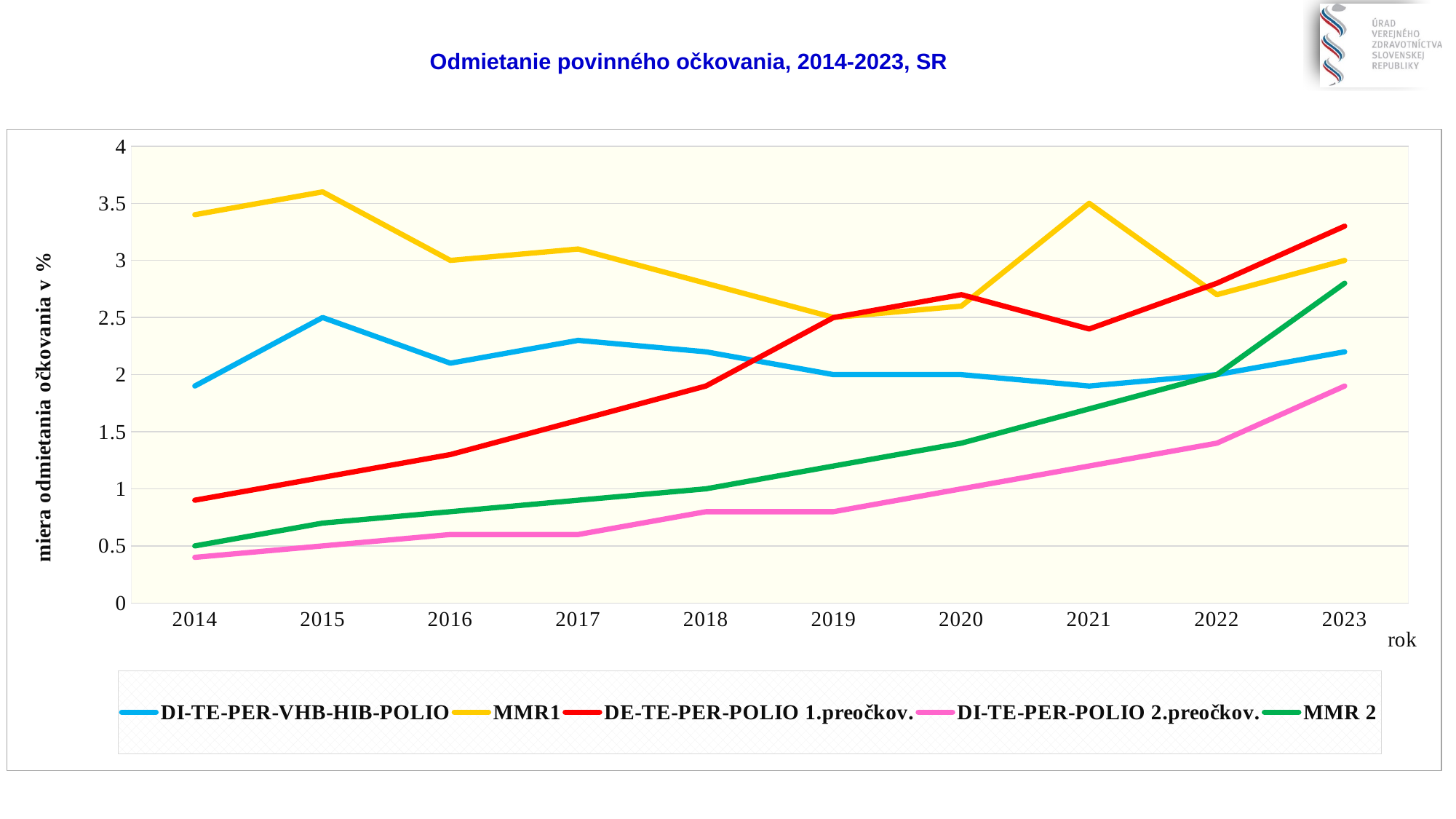
Which series has the highest value in 2014? MMR1 Which series has the highest value in 2023? DE-TE-PER-POLIO 1.preočkov. Does the MMR 2 series rise or fall from 2014 to 2023? rise What kind of chart is shown on the slide? line chart Is the value for MMR1 in 2015 greater or less than 3? greater Is the value for DI-TE-PER-POLIO 2.preočkov. in 2014 greater or less than 0.5? less How many years are shown on the x axis? 10 How many series does the legend list? 5 What is the title of the chart? Odmietanie povinného očkovania, 2014-2023, SR In 2021, which is larger: MMR1 or DE-TE-PER-POLIO 1.preočkov.? MMR1 Which series has the lowest value in 2014? DI-TE-PER-POLIO 2.preočkov. Is the value for DE-TE-PER-POLIO 1.preočkov. in 2023 greater or less than 3? greater